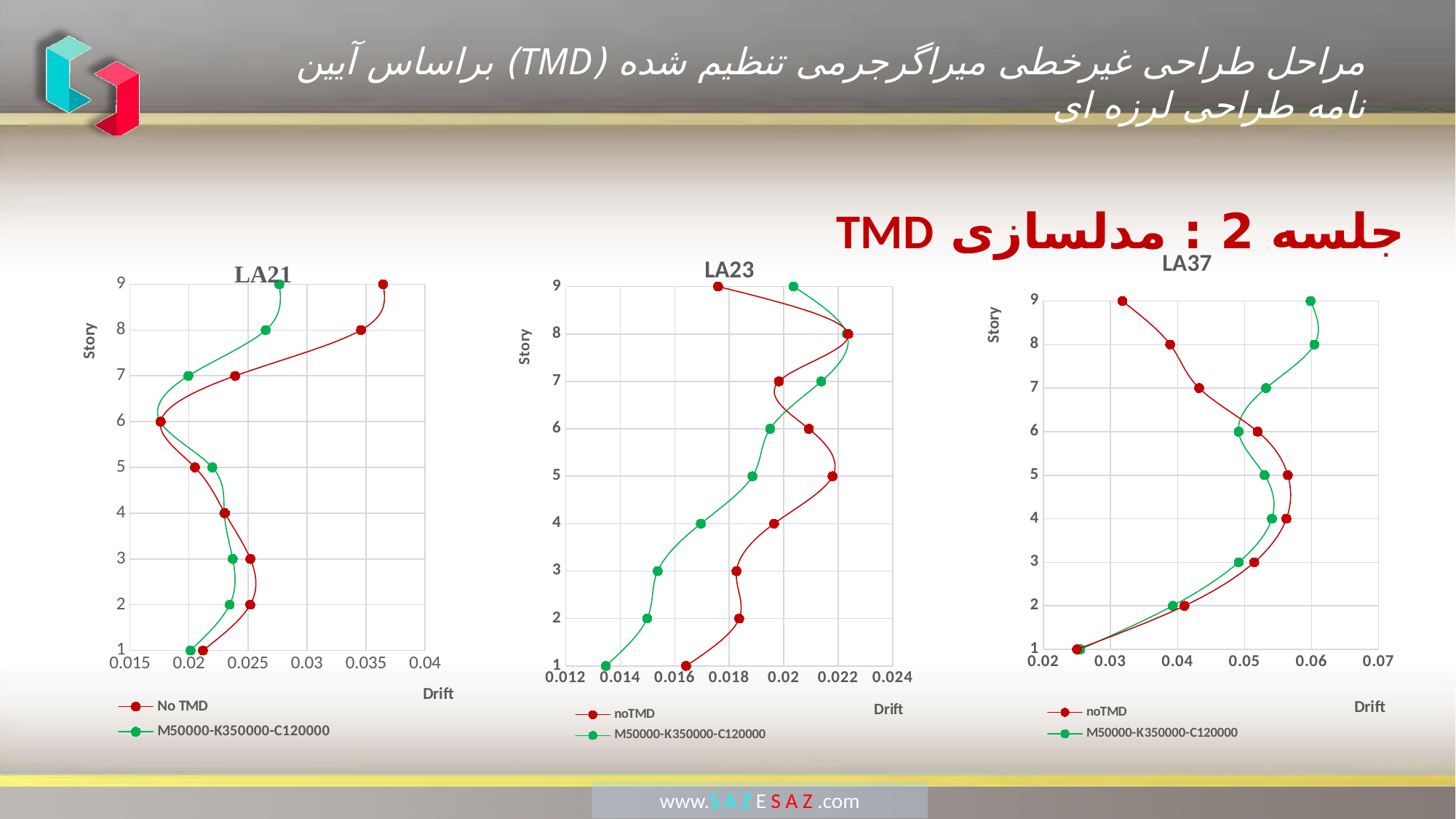
In the LA21 chart, is the No TMD drift at story 6 greater or less than 0.02? less In the LA21 chart, is the No TMD drift at story 9 greater or less than 0.035? greater How many series does the legend of the LA23 chart list? 2 How many story points are plotted for the noTMD series in the LA37 chart? 9 In the LA37 chart, is the noTMD drift at story 9 greater or less than 0.03? greater In the LA23 chart, at story 5, which series has the larger drift, noTMD or M50000-K350000-C120000? noTMD In the LA21 chart, at which story does the No TMD series reach its highest drift? 9 In the LA37 chart, at story 9, which series has the larger drift, noTMD or M50000-K350000-C120000? M50000-K350000-C120000